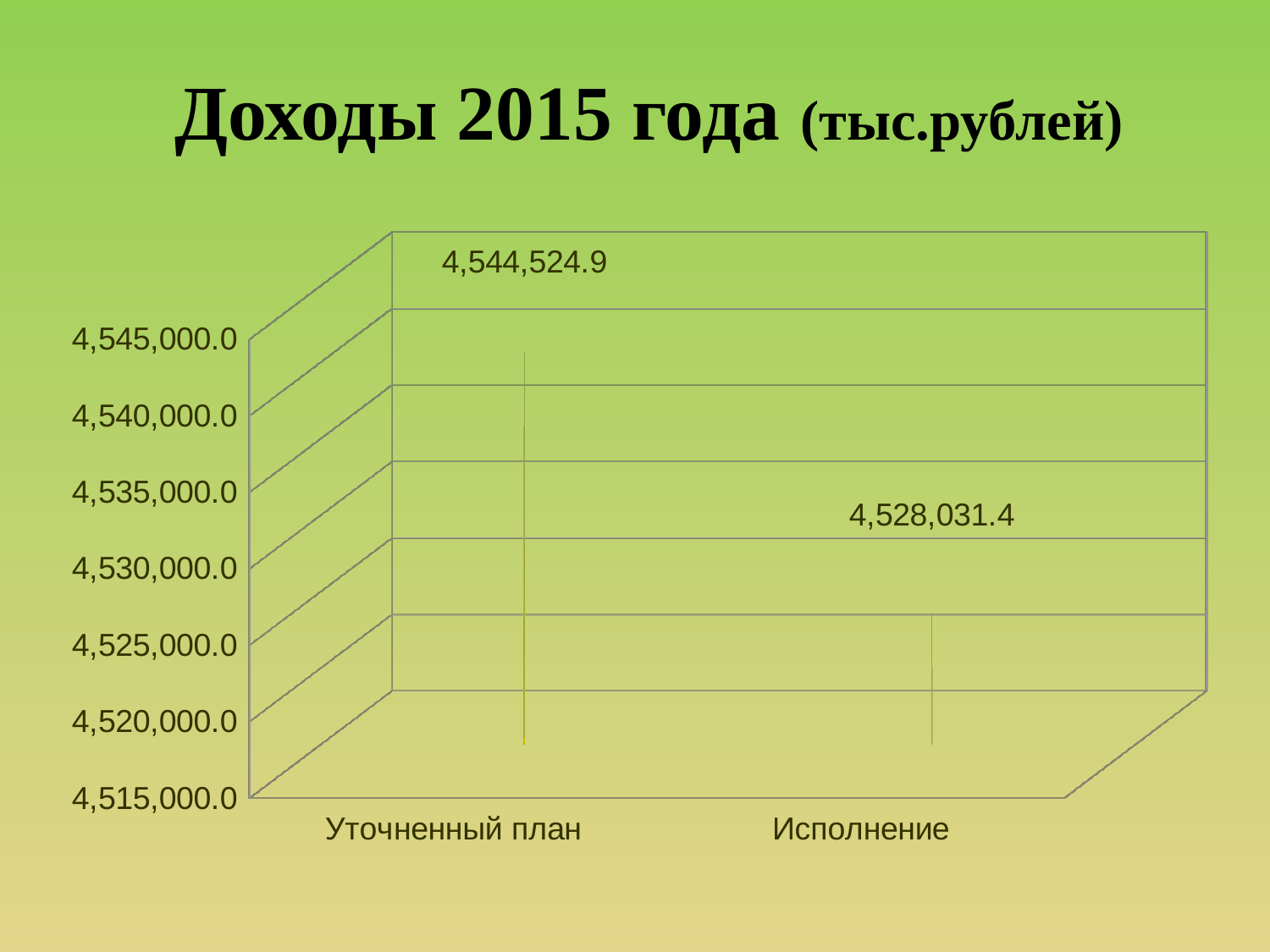
Which category has the lower value? Исполнение What kind of chart is shown on the slide? bar chart What is the difference between the values for Уточненный план and Исполнение? 16,493.5 What is the value for Уточненный план? 4,544,524.9 What is the value for Исполнение? 4,528,031.4 Is the value for Уточненный план larger or smaller than the value for Исполнение? larger Is the value for Исполнение greater or less than 4,530,000.0? less Is the value for Уточненный план greater or less than 4,540,000.0? greater How many categories are shown on the x axis? 2 What is the title of the chart on the slide? Доходы 2015 года (тыс.рублей) What is the lowest value shown on the vertical axis? 4,515,000.0 Which category has the higher value? Уточненный план